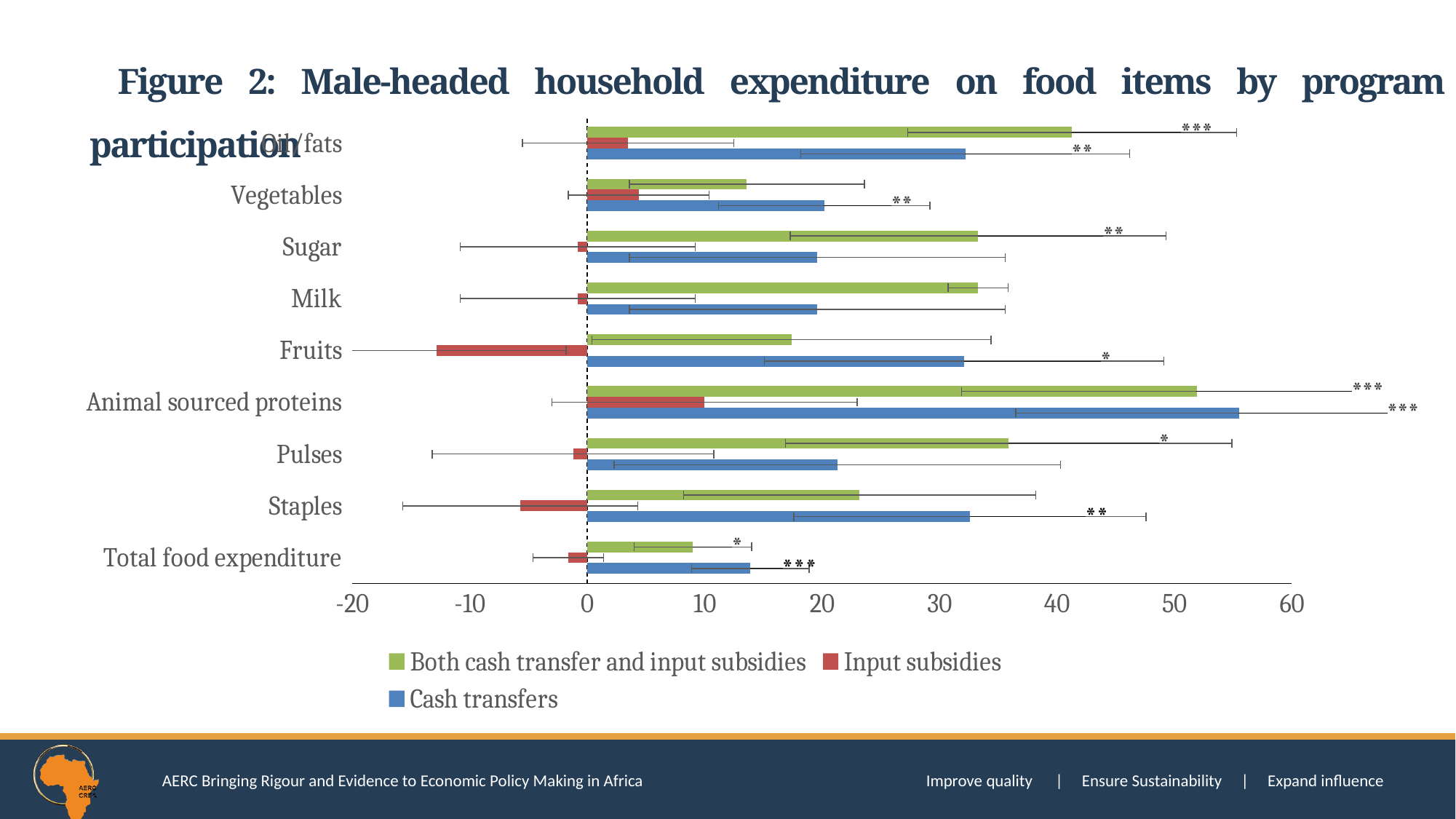
Which category has the highest value for the 'Both cash transfer and input subsidies' series? Animal sourced proteins Which category has the lowest value for the 'Both cash transfer and input subsidies' series? Total food expenditure How many series does the legend list? 3 Which series is shown in green in the legend? Both cash transfer and input subsidies Is the 'Cash transfers' value for Animal sourced proteins greater or less than 50? greater Is the 'Cash transfers' value for Total food expenditure greater or less than 20? less Which category has the highest value for the 'Cash transfers' series? Animal sourced proteins How many food item categories are plotted on the chart? 9 For Fruits, which is larger: the 'Cash transfers' value or the 'Both cash transfer and input subsidies' value? Cash transfers What kind of chart is shown on the slide? Bar chart Is the 'Input subsidies' value for Fruits greater or less than -10? less Which category has the lowest value for the 'Input subsidies' series? Fruits